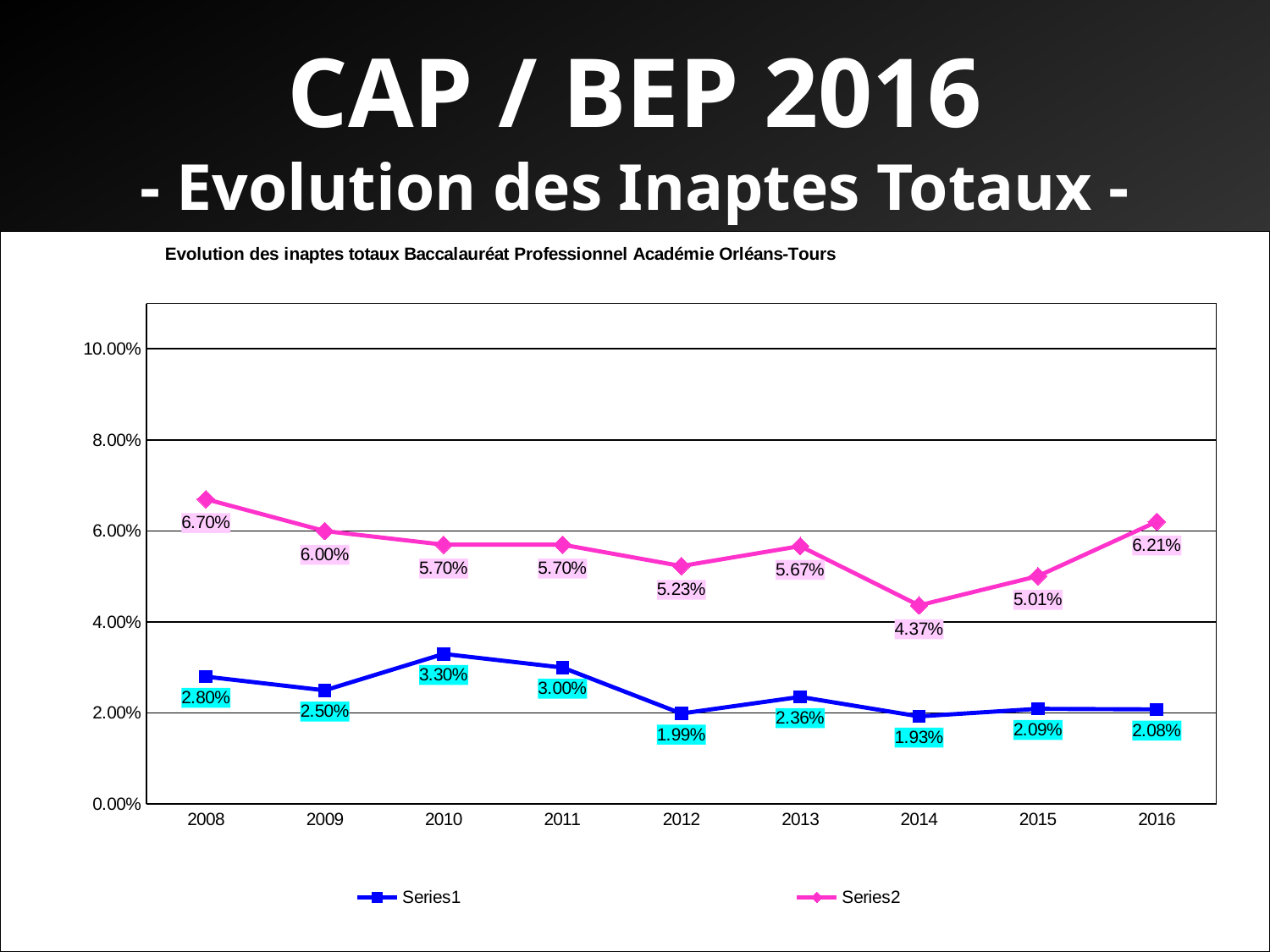
Which is larger in 2012, Series1 or Series2? Series2 What is the value of Series1 in 2014? 1.93% What kind of chart is shown? Line chart How many years are shown on the x axis? 9 What is the value of Series1 in 2016? 2.08% In which year is Series2 at its lowest? 2014 Is the value of Series2 in 2014 greater or less than 4.00%? greater In which year is Series1 at its highest? 2010 What is the difference between Series2 and Series1 in 2016? 4.13% Does Series2 rise or fall from 2014 to 2016? Rise How many series does the legend list? 2 What is the value of Series2 in 2008? 6.70%